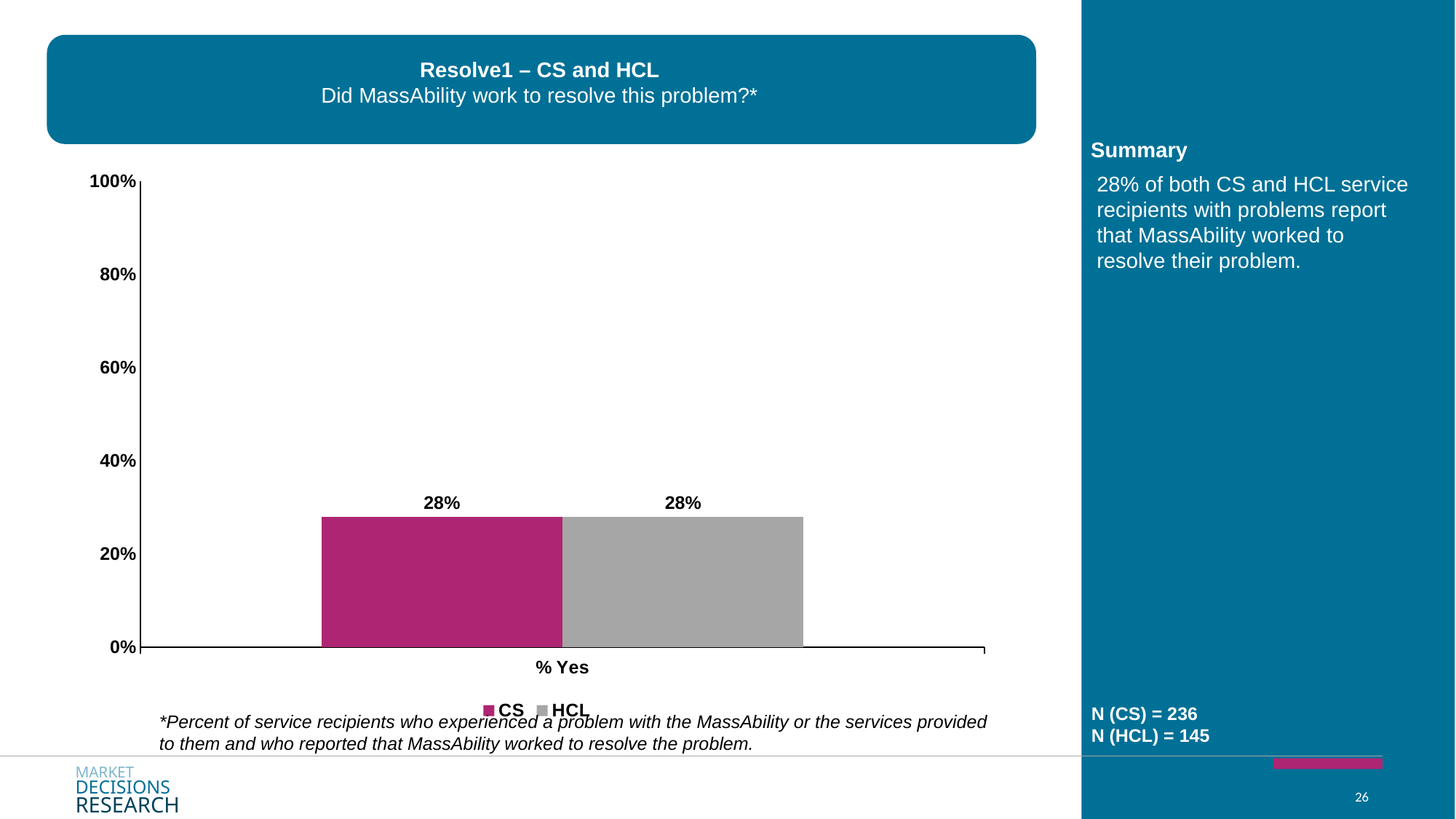
How many categories are shown on the x axis? 1 Is the value for HCL greater or less than 20%? greater What is the value for HCL in the % Yes category? 28% What is the difference between the CS and HCL values for % Yes? 0% How many series does the legend list? 2 Which series is shown in magenta in the legend? CS What is the label of the category on the x axis? % Yes Is the value for CS greater or less than 40%? less What kind of chart is shown on the slide? bar chart What is the maximum value shown on the y axis? 100% What is the value for CS in the % Yes category? 28%